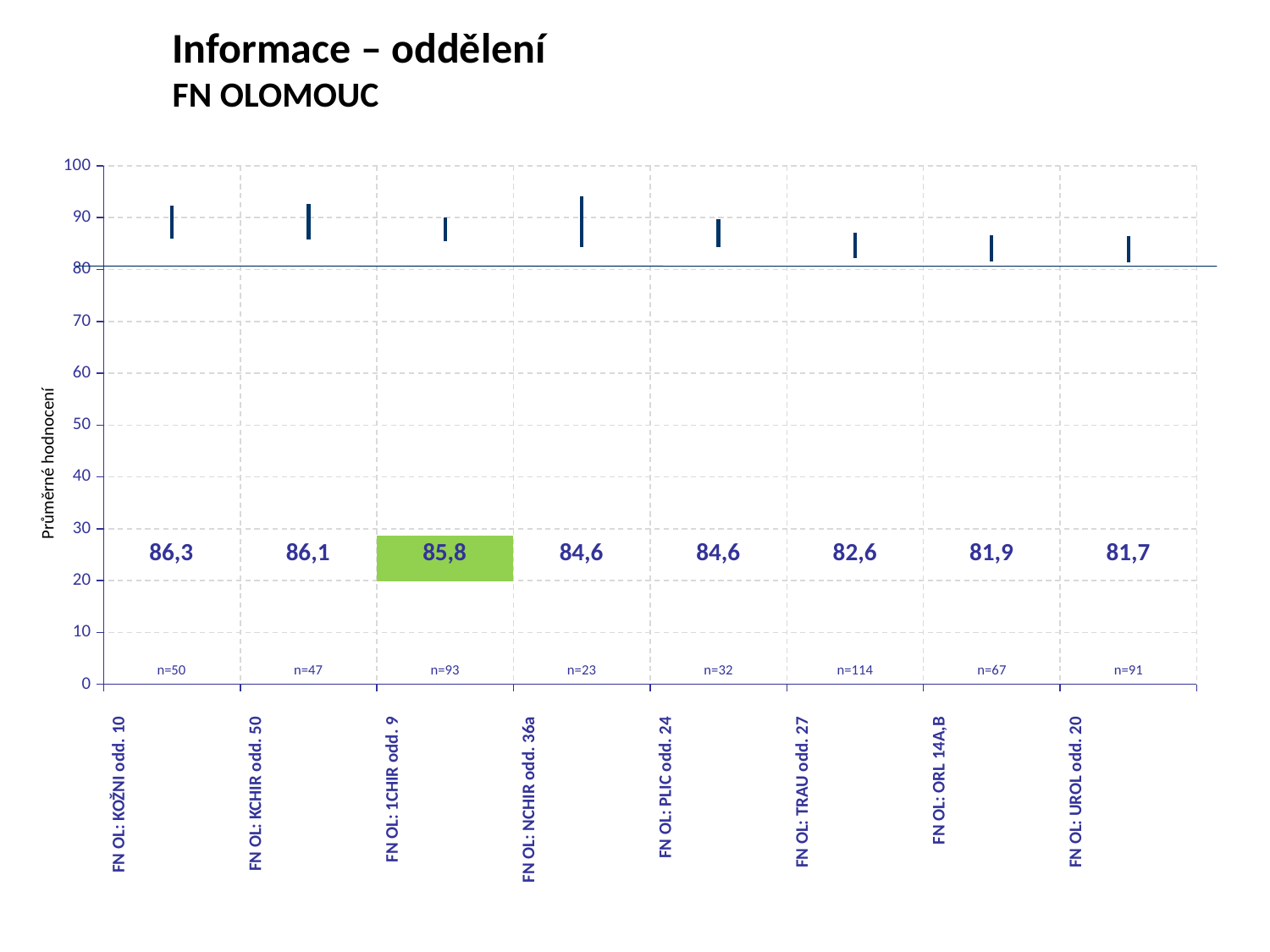
What is the difference between the average ratings of FN OL: KOŽNI odd. 10 and FN OL: UROL odd. 20? 4,6 What is the average rating shown for FN OL: 1CHIR odd. 9? 85,8 How many departments are shown on the chart? 8 Which department has the highest average rating? FN OL: KOŽNI odd. 10 What is the average rating shown for FN OL: TRAU odd. 27? 82,6 What is the sample size (n) shown for FN OL: TRAU odd. 27? n=114 What is the average rating (průměrné hodnocení) for FN OL: KOŽNI odd. 10? 86,3 Which department has the smallest sample size (n)? FN OL: NCHIR odd. 36a Do the average ratings rise or fall from left to right along the x axis? fall Which department's value label is highlighted with a green box? FN OL: 1CHIR odd. 9 Which department has the lowest average rating? FN OL: UROL odd. 20 Which has a higher average rating, FN OL: KCHIR odd. 50 or FN OL: ORL 14A,B? FN OL: KCHIR odd. 50